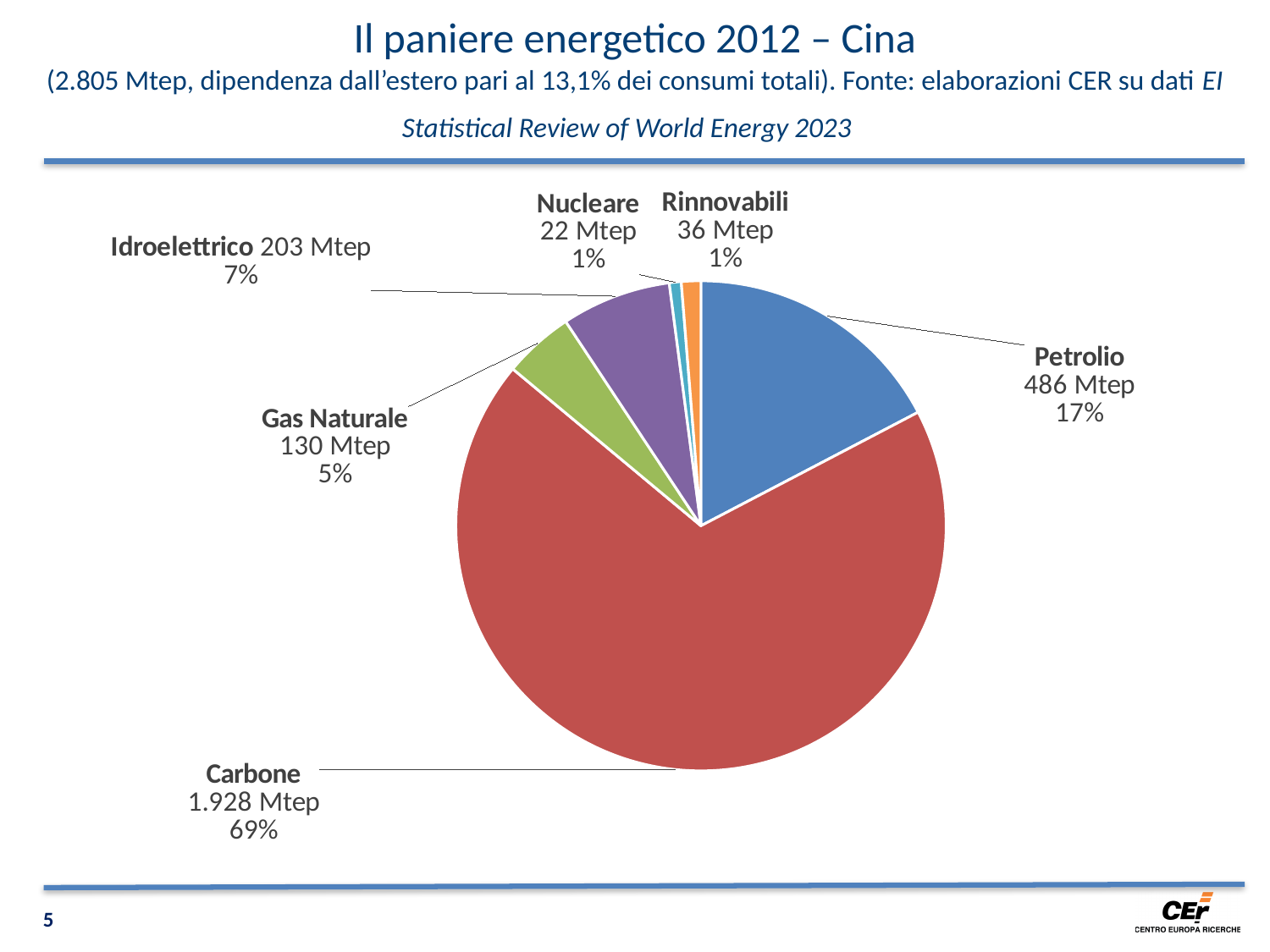
What is the value for Idroelettrico? 203 Mtep What is the value for Petrolio? 486 Mtep What share of the pie does Carbone represent? 69% How many Mtep does Carbone account for? 1.928 Mtep Which is larger, Rinnovabili or Nucleare? Rinnovabili What is the value for Gas Naturale? 130 Mtep Which energy source has the smallest slice of the pie? Nucleare How many energy sources are shown in the pie chart? 6 Which energy source has the largest slice of the pie? Carbone What kind of chart is shown on the slide? pie chart What is the difference in Mtep between Petrolio and Idroelettrico? 283 Mtep What share of the pie does Petrolio represent? 17%